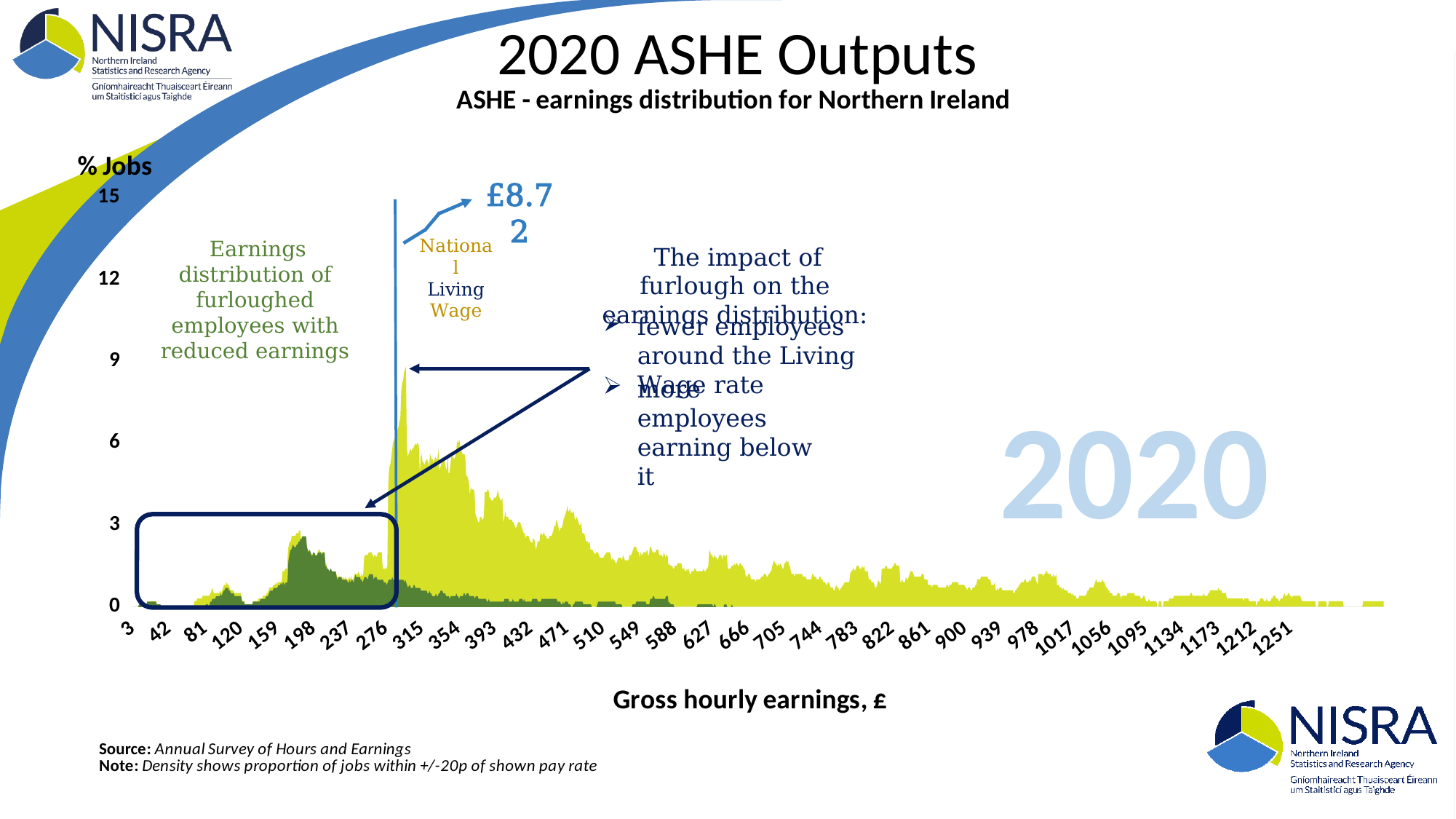
Is the value of the earnings distribution at 1251 greater or less than 3% of jobs? less What is the label of the x axis of the chart? Gross hourly earnings, £ Is the value of the earnings distribution at 900 greater or less than 3% of jobs? less Which has the larger share of jobs: gross hourly earnings around 315 or around 900? 315 What is the highest value shown on the y axis of the chart? 15 What is the lowest tick label shown on the x axis of the chart? 3 Moving along the x axis from 315 to 1251, do the values of the earnings distribution generally rise or fall? fall Is the peak of the furloughed employees distribution near 198 greater or less than 6% of jobs? less What is the title of the chart on the slide? ASHE - earnings distribution for Northern Ireland What National Living Wage value is marked on the chart? £8.72 What kind of chart is shown on the slide? area chart